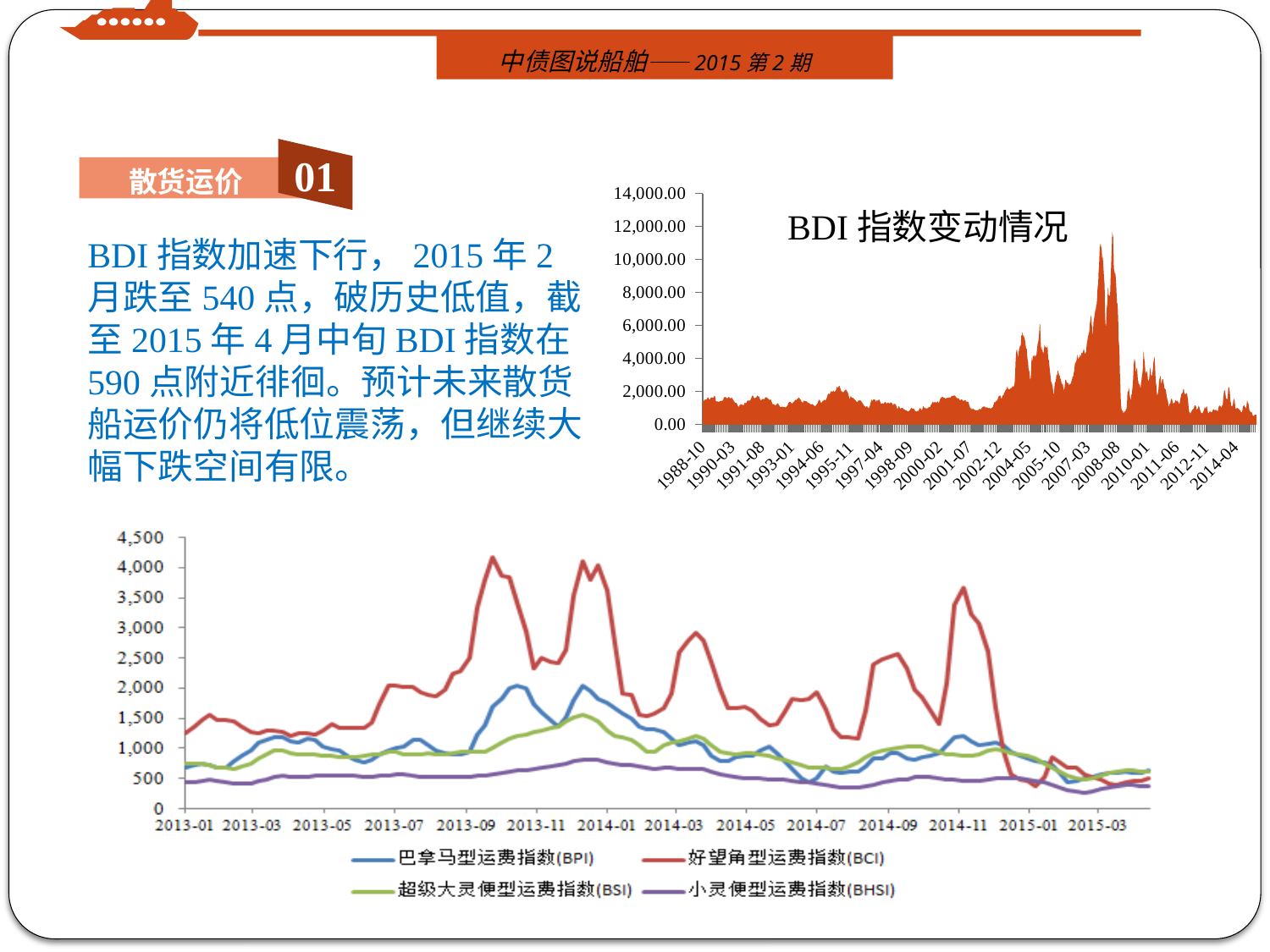
In the top-right chart BDI 指数变动情况, is the value at 2014-04 greater or less than 2,000.00? less What kind of chart is the top-right chart titled BDI 指数变动情况? area chart How many series does the legend of the bottom chart list? 4 In the bottom chart, which is larger at 2014-11: 好望角型运费指数(BCI) or 巴拿马型运费指数(BPI)? 好望角型运费指数(BCI) In the bottom chart, which series has the lowest value at 2014-01? 小灵便型运费指数(BHSI) What is the title of the top-right chart? BDI 指数变动情况 What kind of chart is the bottom chart showing the four freight indices? line chart In the bottom chart, does 好望角型运费指数(BCI) rise or fall from 2014-11 to 2015-01? fall In the bottom chart, is the peak of 好望角型运费指数(BCI) around 2013-09 greater or less than 3,500? greater In the top-right chart BDI 指数变动情况, is the peak value around 2008 greater or less than 10,000.00? greater In the bottom chart, which series has the highest value at 2013-01? 好望角型运费指数(BCI)